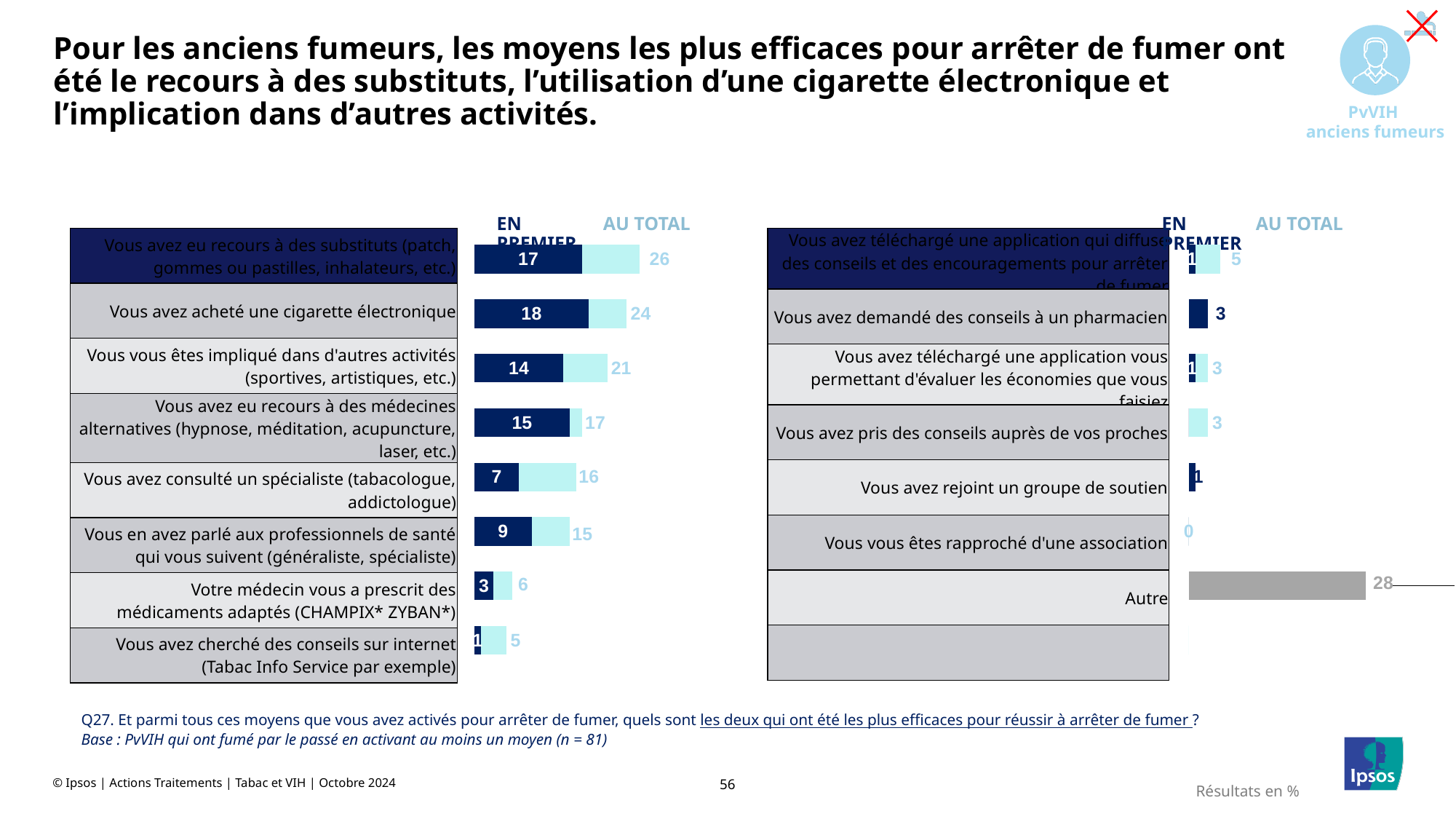
In the left chart, what is the 'AU TOTAL' value for 'Vous avez eu recours à des substituts (patch, gommes ou pastilles, inhalateurs, etc.)'? 26 In the right chart, what is the value for 'Vous vous êtes rapproché d'une association'? 0 In the left chart, which category has the lowest 'AU TOTAL' value? Vous avez cherché des conseils sur internet (Tabac Info Service par exemple) What are the two series labels shown above the charts? EN PREMIER and AU TOTAL In the left chart, what is the difference between the 'AU TOTAL' and 'EN PREMIER' values for 'Vous avez consulté un spécialiste (tabacologue, addictologue)'? 9 In the left chart, which is larger: the 'EN PREMIER' value for 'Vous avez acheté une cigarette électronique' or for 'Vous vous êtes impliqué dans d'autres activités (sportives, artistiques, etc.)'? Vous avez acheté une cigarette électronique In the right chart, what is the value for 'Autre'? 28 What type of chart is used on this slide? Bar chart How many categories are shown in the left chart? 8 In the left chart, which category has the highest 'AU TOTAL' value? Vous avez eu recours à des substituts (patch, gommes ou pastilles, inhalateurs, etc.) In the right chart, what is the 'AU TOTAL' value for 'Vous avez téléchargé une application qui diffuse des conseils et des encouragements pour arrêter de fumer'? 5 In the left chart, what is the 'EN PREMIER' value for 'Vous avez acheté une cigarette électronique'? 18